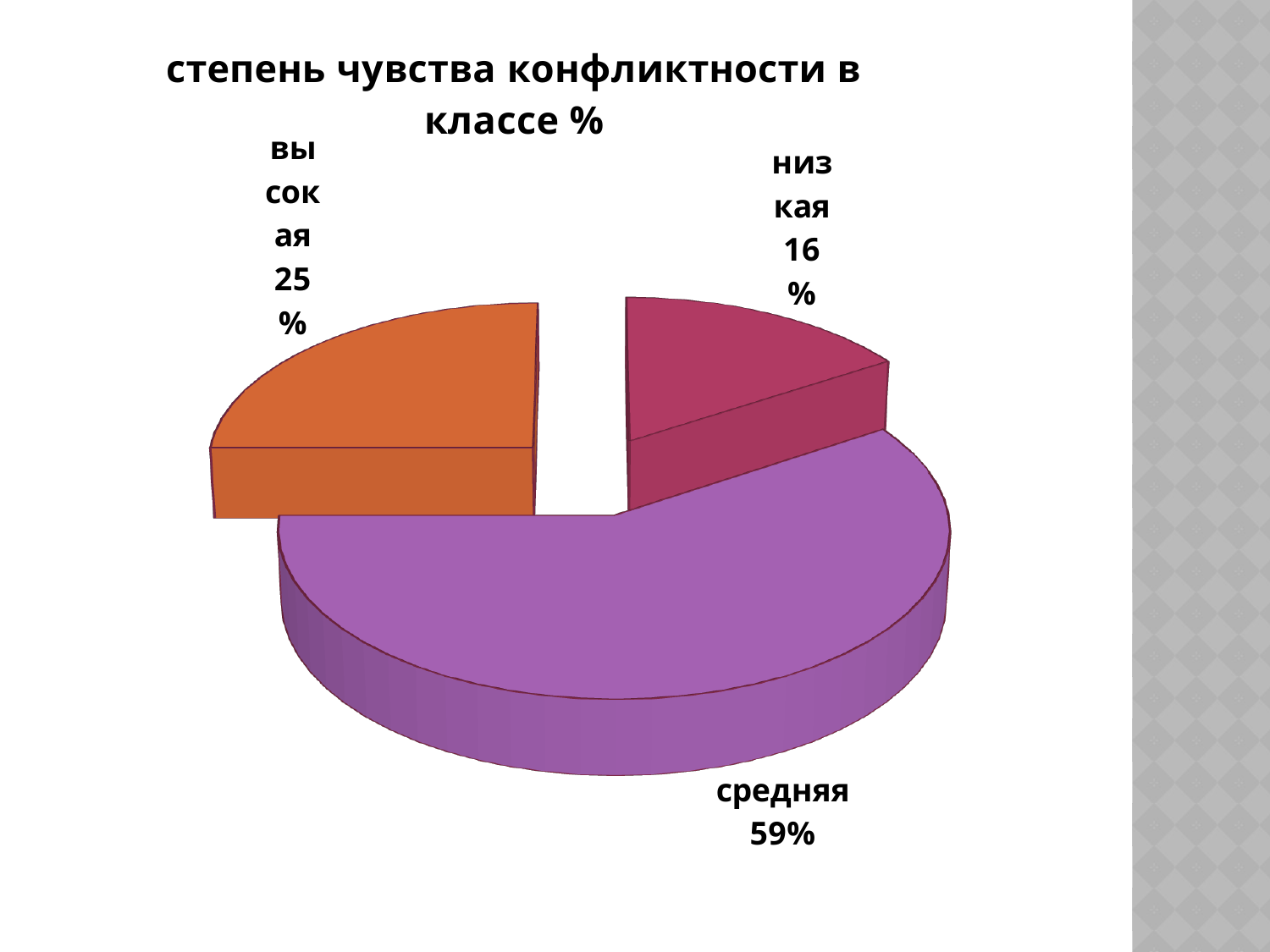
Which is larger, the value for "высокая" or the value for "низкая"? высокая Which category has the largest share of the pie? средняя What is the value for the slice labelled "высокая"? 25% How many slices does the pie chart have? 3 What kind of chart is shown on the slide? pie chart What is the title of the chart? степень чувства конфликтности в классе % Which category has the smallest share of the pie? низкая What colour is the slice labelled "средняя"? purple What is the difference between the values for "средняя" and "высокая"? 34% What is the difference between the values for "высокая" and "низкая"? 9% What is the value for the slice labelled "низкая"? 16% What is the value for the slice labelled "средняя"? 59%